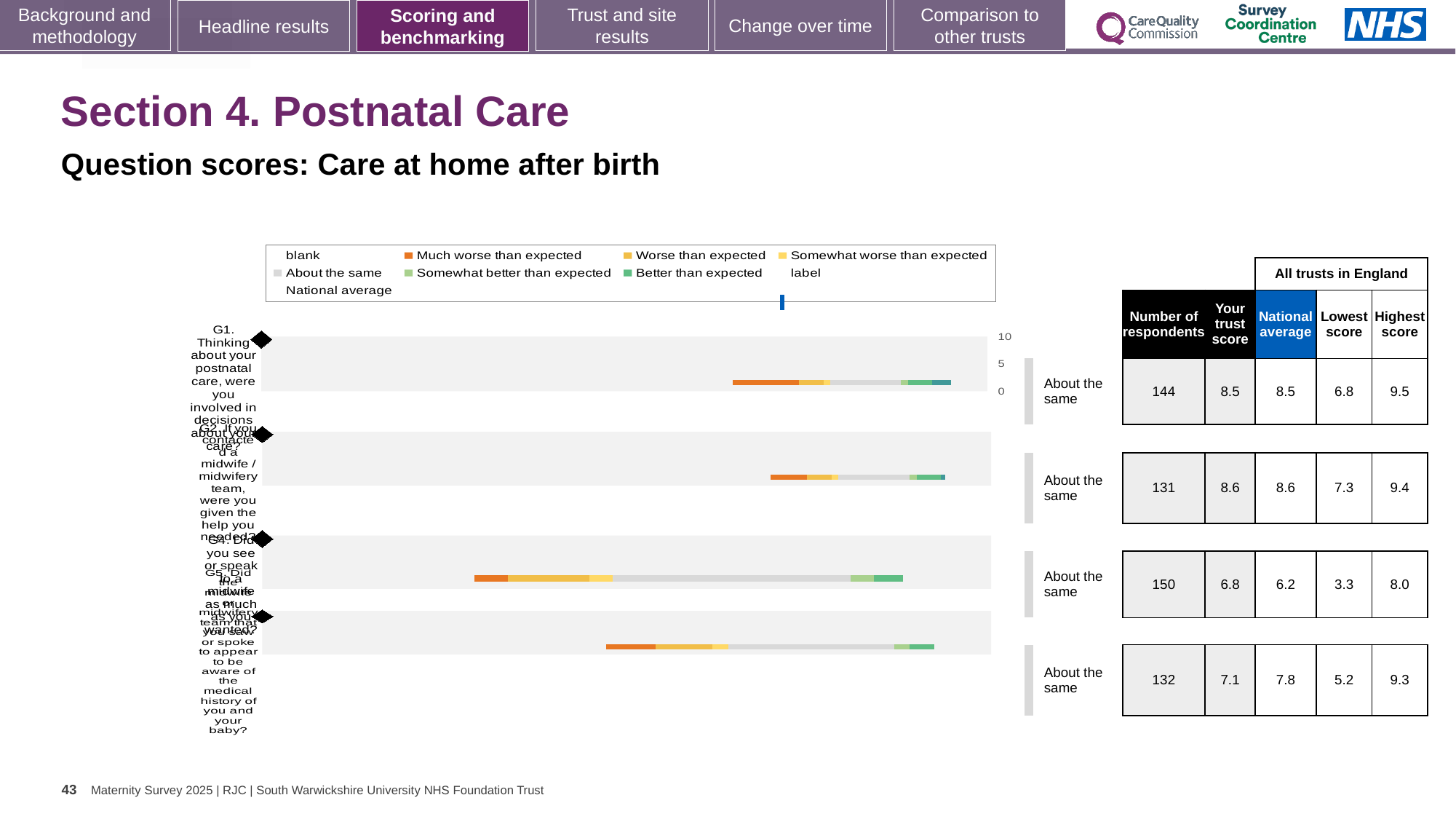
What is the trust score for question G4 in the table beside the chart? 6.8 In the chart legend, what colour represents 'Much worse than expected'? orange What kind of chart is shown on the slide? bar chart What is the subtitle of the chart section on the slide? Question scores: Care at home after birth What is the highest score in England for question G2 in the table beside the chart? 9.4 What is the number of respondents for question G1 in the table beside the chart? 144 For question G4, which is larger: the trust score or the national average? trust score Which question has the highest number of respondents in the table beside the chart? G4 Which question has the lowest 'Lowest score' in the table beside the chart? G4 What is the difference between the national average and the trust score for question G5? 0.7 What is the national average for question G5 in the table beside the chart? 7.8 How many question bars (G1, G2, G4, G5) are plotted in the chart? 4